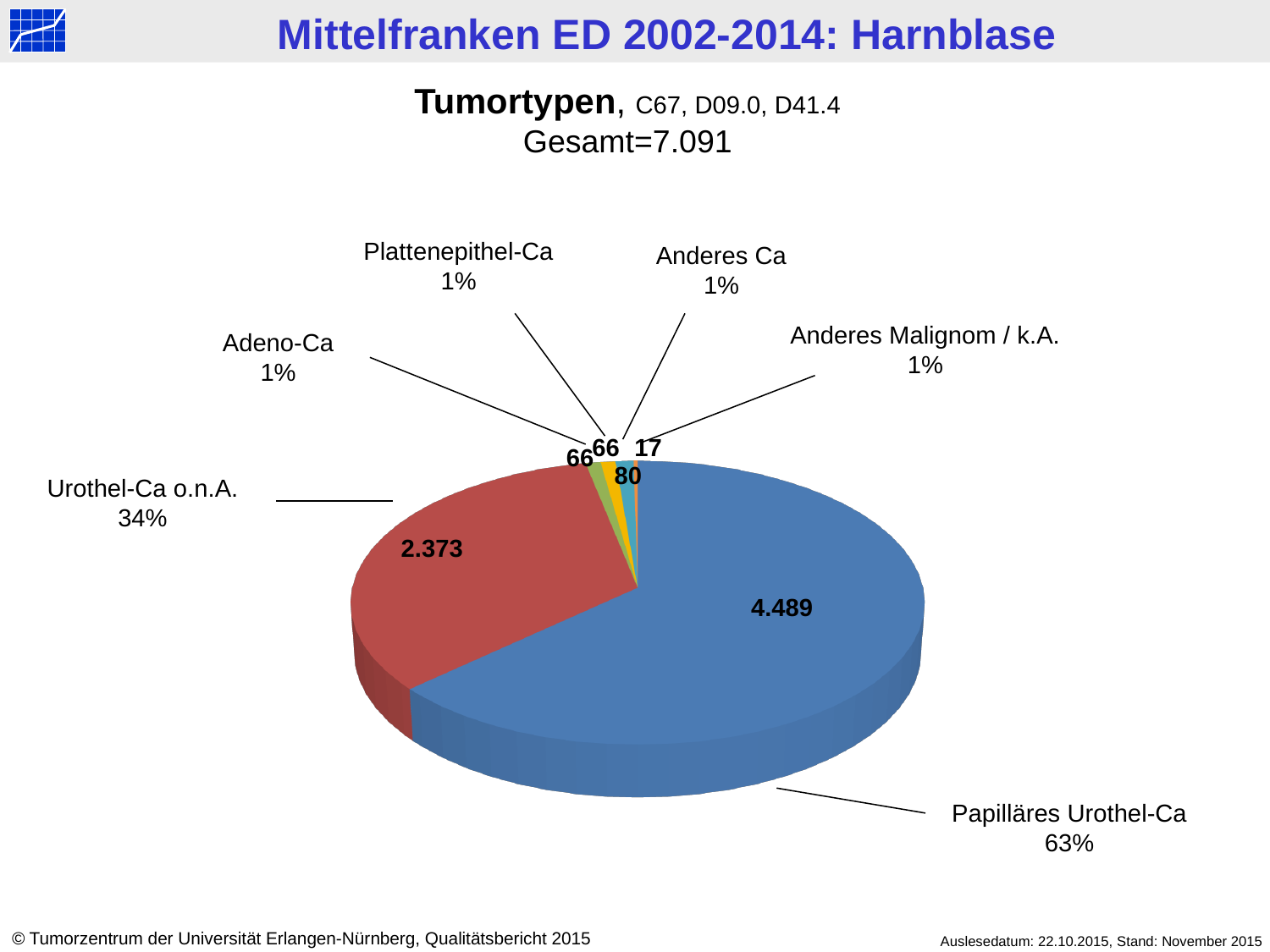
What is the difference between the values for Papilläres Urothel-Ca and Urothel-Ca o.n.A.? 2.116 How many slices does the pie chart have? 6 What is the title of the chart? Tumortypen, C67, D09.0, D41.4 Which is larger, the value for Urothel-Ca o.n.A. or the value for Papilläres Urothel-Ca? Papilläres Urothel-Ca What is the value for Urothel-Ca o.n.A.? 2.373 What kind of chart is shown on the slide? pie chart What total (Gesamt) is stated for the chart? 7.091 What share of the pie does Papilläres Urothel-Ca represent? 63% Which tumour type has the largest slice? Papilläres Urothel-Ca What is the value for Papilläres Urothel-Ca? 4.489 What share of the pie does Adeno-Ca represent? 1% What share of the pie does Urothel-Ca o.n.A. represent? 34%